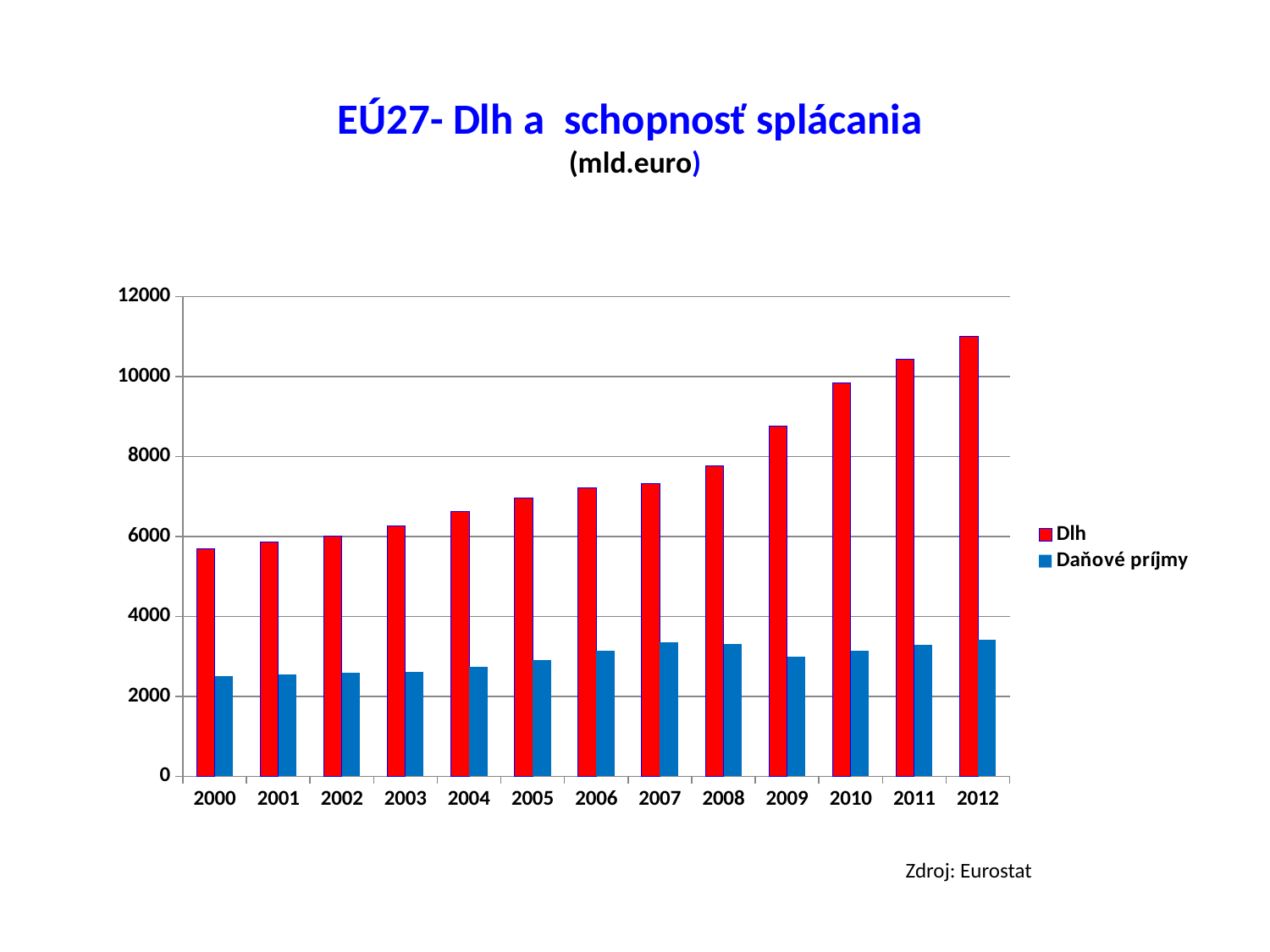
Which series has the larger value in 2012, Dlh or Daňové príjmy? Dlh Is the Daňové príjmy value for 2007 greater or less than 4000? less In which year is the Dlh value highest? 2012 Is the Dlh value for 2012 greater or less than 10000? greater How many series does the legend list? 2 Is the Dlh value for 2000 greater or less than 6000? less Does the Dlh series rise or fall from 2000 to 2012? rise What kind of chart is shown on the slide? bar chart How many years are shown on the x axis? 13 In which year is the Dlh value lowest? 2000 Which colour represents the Dlh series? red